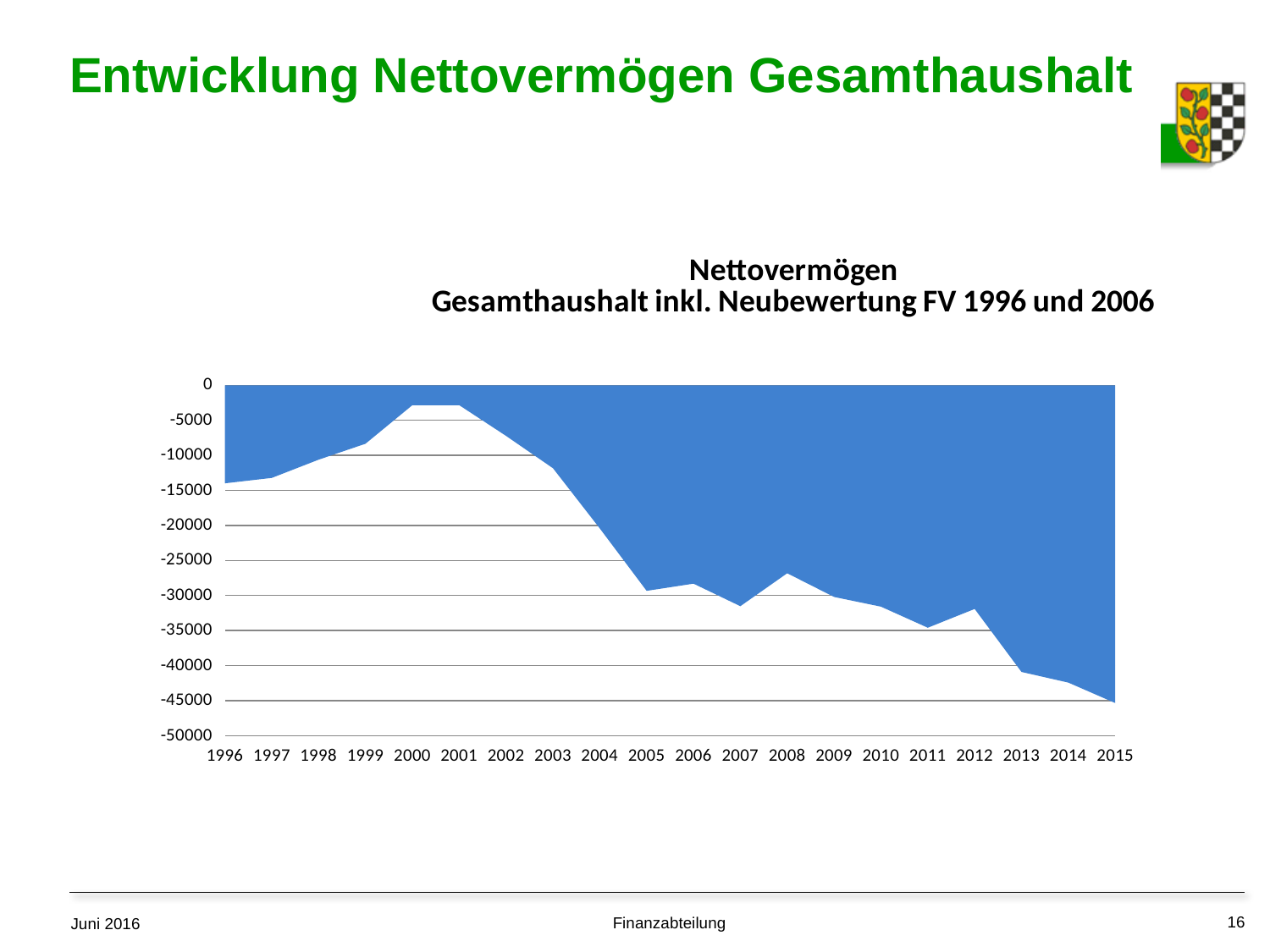
Overall, do the values rise or fall from 2001 to 2015? fall What is the last year shown on the x axis? 2015 How many years are shown on the x axis of the chart? 20 Is the value for 1996 greater or less than -15000? greater Which year has the lowest Nettovermögen value? 2015 Is the value for 2013 greater or less than -35000? less Is the value for 2015 greater or less than -40000? less Which year has the larger value, 1996 or 2015? 1996 What kind of chart is shown on the slide? area chart What is the first year shown on the x axis? 1996